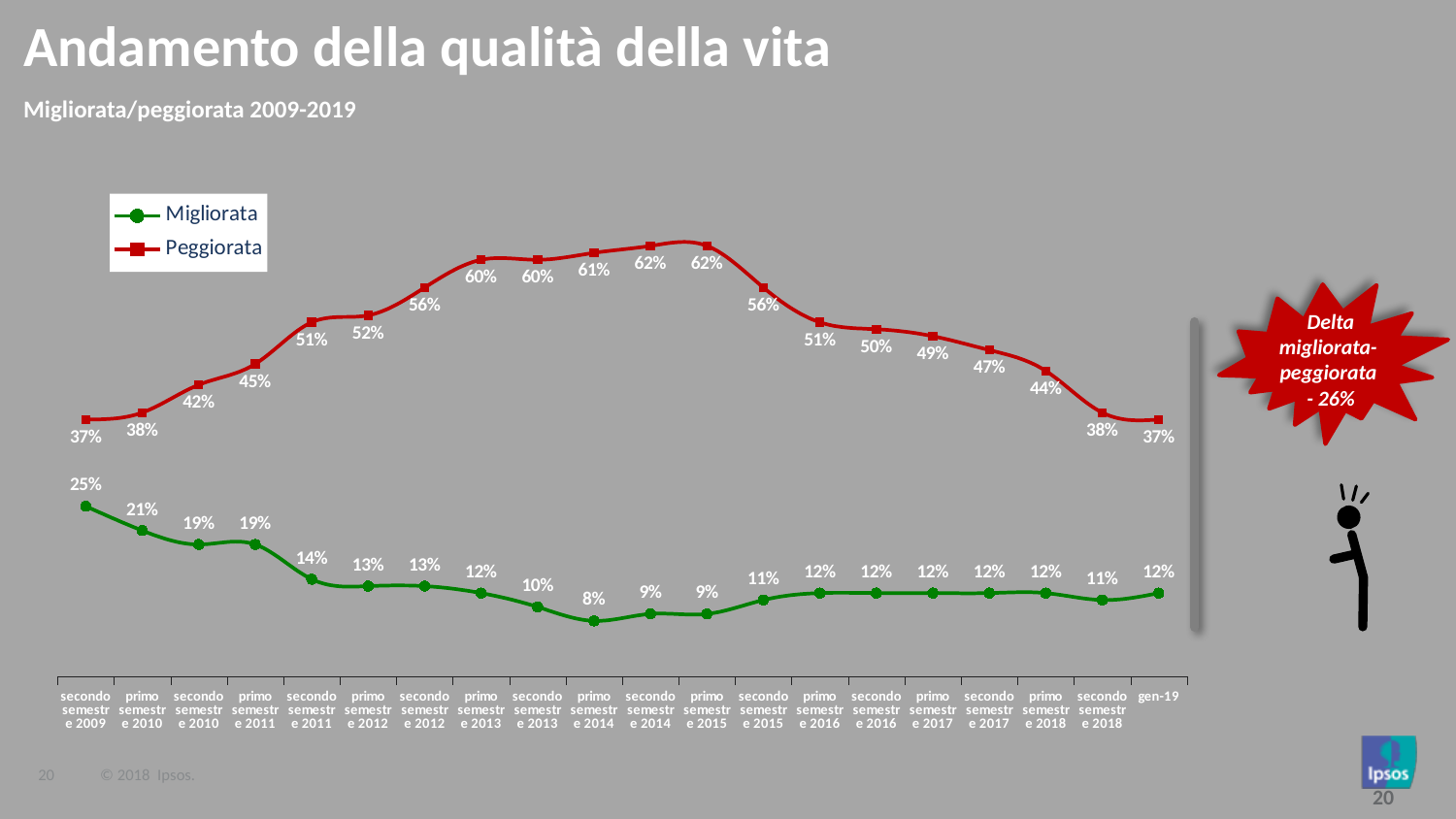
What is the highest value reached by the Peggiorata series? 62% What is the difference between the Peggiorata and Migliorata values at gen-19? 25 percentage points What is the Peggiorata value for primo semestre 2014? 61% What is the Migliorata value for secondo semestre 2009? 25% What delta between migliorata and peggiorata is shown in the red callout? - 26% In which period does the Migliorata series reach its lowest value? primo semestre 2014 At secondo semestre 2009, which series has the larger value, Migliorata or Peggiorata? Peggiorata How many series does the legend list? 2 What kind of chart is shown on the slide? Line chart Does the Peggiorata series rise or fall from primo semestre 2015 to gen-19? Fall How many data points does each series have on the x axis? 20 What is the Migliorata value for primo semestre 2014? 8%